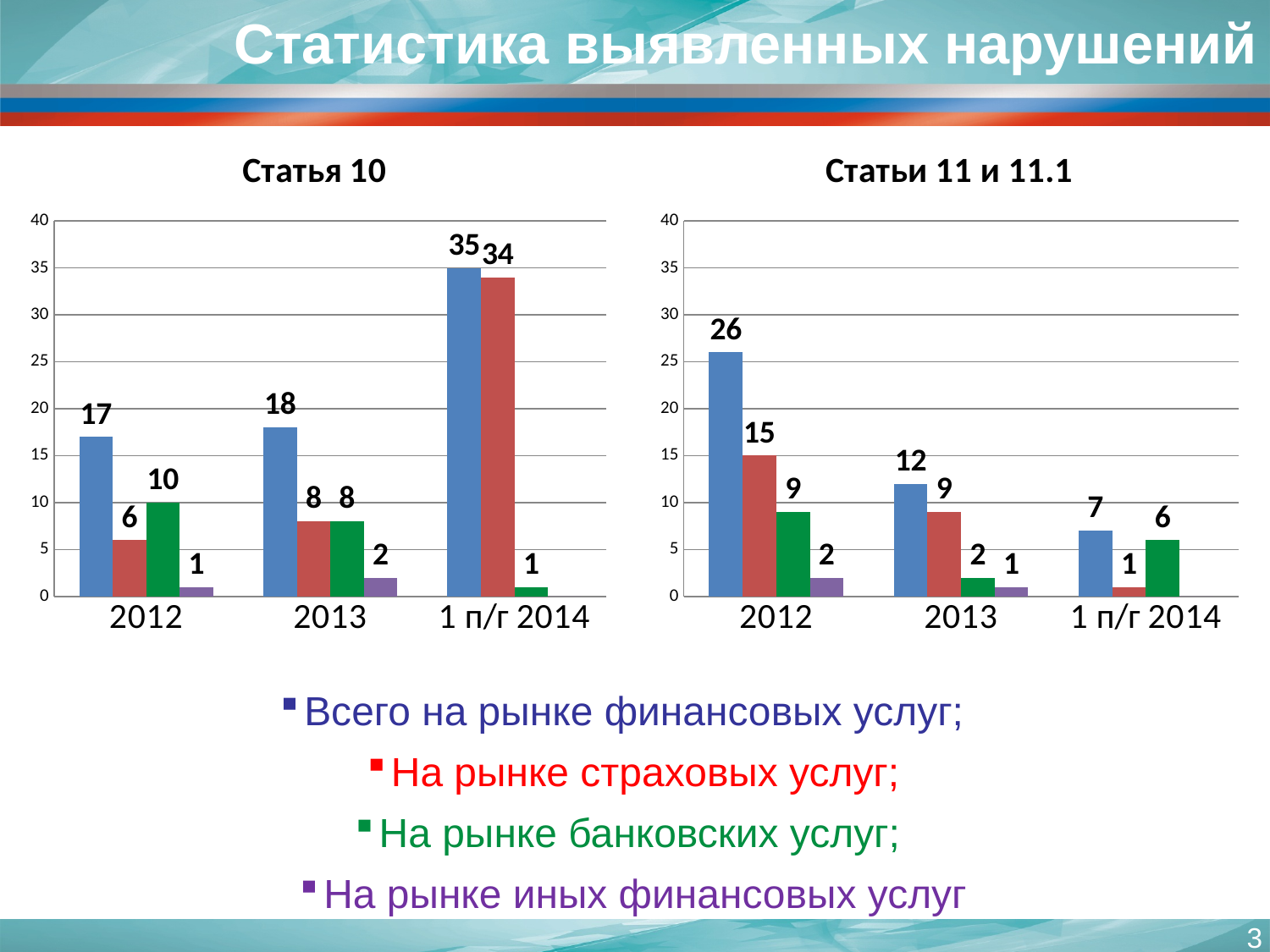
In the chart titled "Статья 10", what is the difference between the blue bar for 1 п/г 2014 and the blue bar for 2013? 17 How many periods are shown on the x axis of the chart titled "Статья 10"? 3 In the chart titled "Статьи 11 и 11.1", in which year is the blue bar (Всего на рынке финансовых услуг) highest? 2012 In the chart titled "Статья 10", what is the value of the red bar (На рынке страховых услуг) for 1 п/г 2014? 34 What type of chart is the chart titled "Статьи 11 и 11.1"? bar chart In the chart titled "Статьи 11 и 11.1", does the blue bar (Всего на рынке финансовых услуг) rise or fall from 2012 to 1 п/г 2014? fall In the chart titled "Статья 10", does the blue bar (Всего на рынке финансовых услуг) rise or fall from 2012 to 1 п/г 2014? rise In the chart titled "Статьи 11 и 11.1", what is the difference between the blue bar and the red bar for 2012? 11 In the chart titled "Статьи 11 и 11.1", what is the value of the green bar (На рынке банковских услуг) for 2012? 9 In the chart titled "Статьи 11 и 11.1", which is larger for 1 п/г 2014: the red bar (страховых услуг) or the green bar (банковских услуг)? the green bar (банковских услуг) In the chart titled "Статья 10", in which period is the green bar (На рынке банковских услуг) lowest? 1 п/г 2014 In the chart titled "Статья 10", what is the value of the blue bar (Всего на рынке финансовых услуг) for 2012? 17